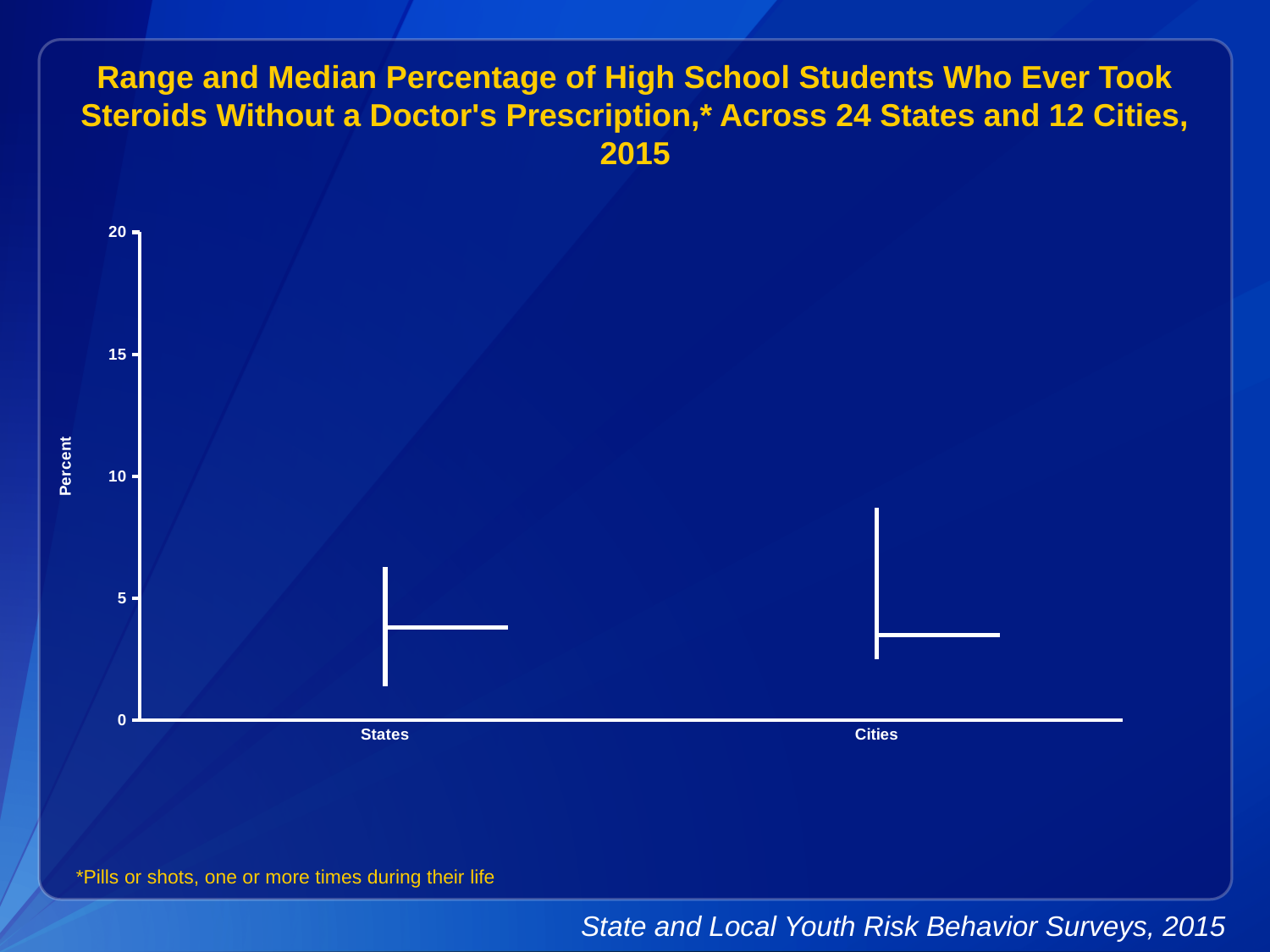
What is the label of the y axis? Percent Which category has the lower bottom of its range, States or Cities? States Is the top of the range for Cities greater or less than 10? less How many categories are shown on the x axis of the chart? 2 What is the highest value shown on the y axis? 20 Is the top of the range for Cities greater or less than 5? greater Which category has the higher top of its range, States or Cities? Cities What are the two categories shown on the x axis? States and Cities Is the top of the range for States greater or less than 5? greater